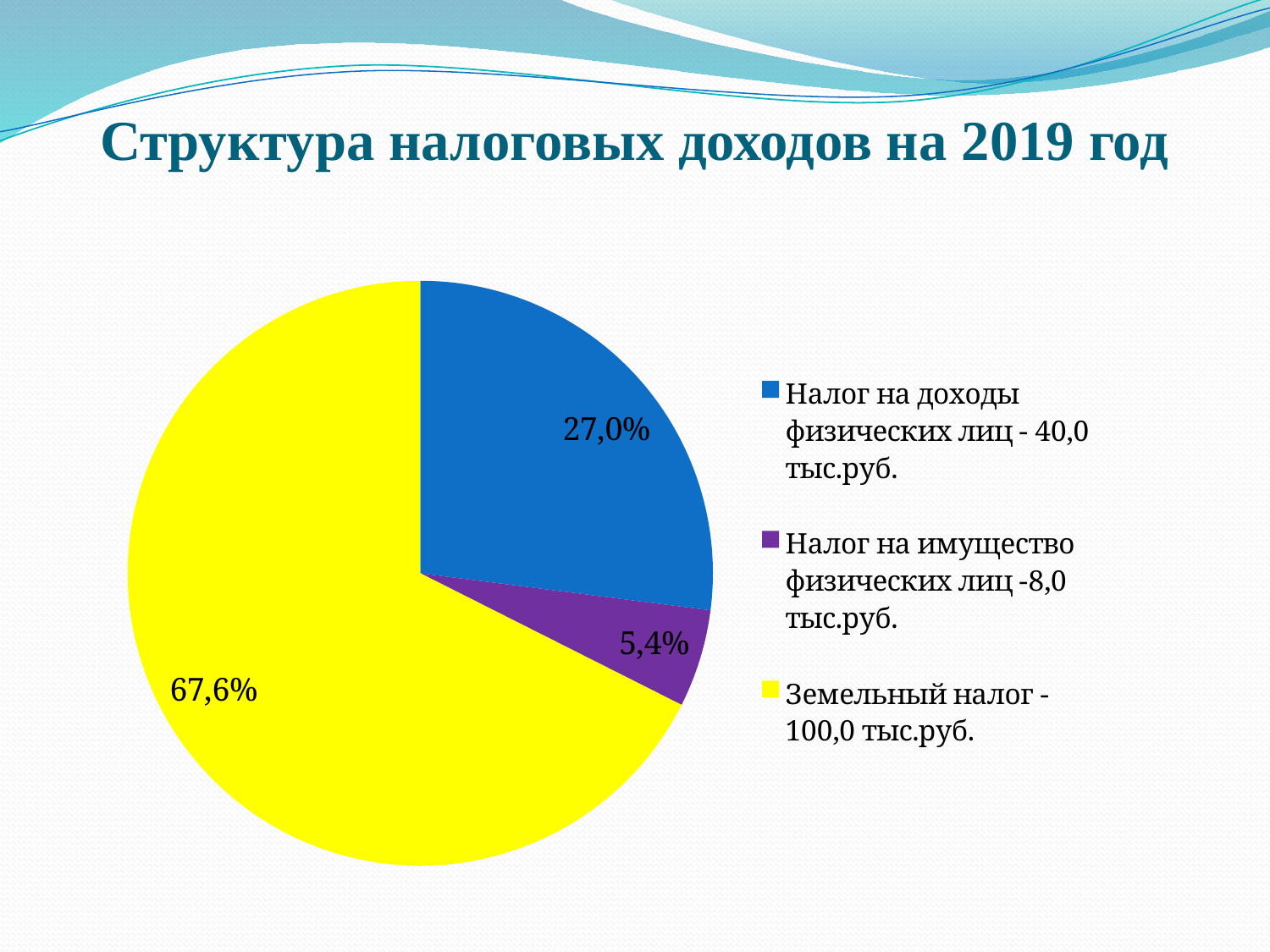
According to the legend, what amount in тыс.руб. corresponds to Земельный налог? 100,0 тыс.руб. What is the title of the chart on the slide? Структура налоговых доходов на 2019 год Which category has the largest slice of the pie? Земельный налог How many slices does the pie chart have? 3 What share of the pie does Налог на имущество физических лиц have? 5,4% What type of chart is shown on the slide? pie chart Which is larger: the share for Налог на доходы физических лиц or the share for Налог на имущество физических лиц? Налог на доходы физических лиц What share of the pie does Земельный налог have? 67,6% What colour is the slice for Налог на имущество физических лиц? purple What is the difference in percentage points between the Земельный налог slice and the Налог на доходы физических лиц slice? 40,6 Which category has the smallest slice of the pie? Налог на имущество физических лиц What share of the pie does Налог на доходы физических лиц have? 27,0%